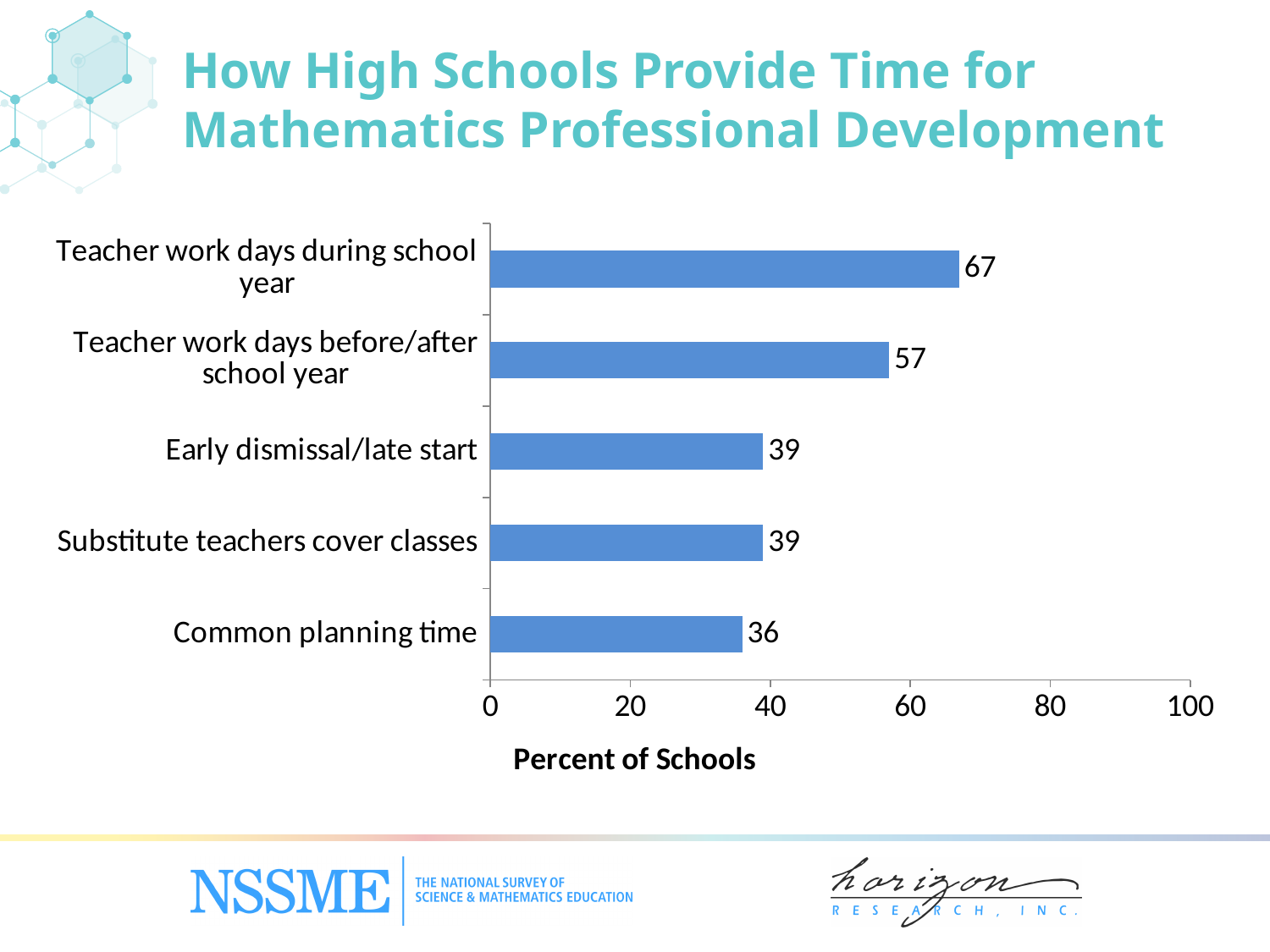
What is the value for 'Early dismissal/late start'? 39 What is the difference between the values for 'Teacher work days during school year' and 'Teacher work days before/after school year'? 10 How many categories are shown in the chart? 5 What percent of schools provide time for mathematics professional development through teacher work days during the school year? 67 What is the label of the horizontal axis? Percent of Schools What kind of chart is shown on the slide? Bar chart What is the value for 'Common planning time'? 36 Which category has the lowest percent of schools? Common planning time What is the difference between the values for 'Substitute teachers cover classes' and 'Common planning time'? 3 Which is larger: the value for 'Teacher work days before/after school year' or the value for 'Early dismissal/late start'? Teacher work days before/after school year Which category has the highest percent of schools? Teacher work days during school year Is the value for 'Teacher work days during school year' greater or less than 60? greater